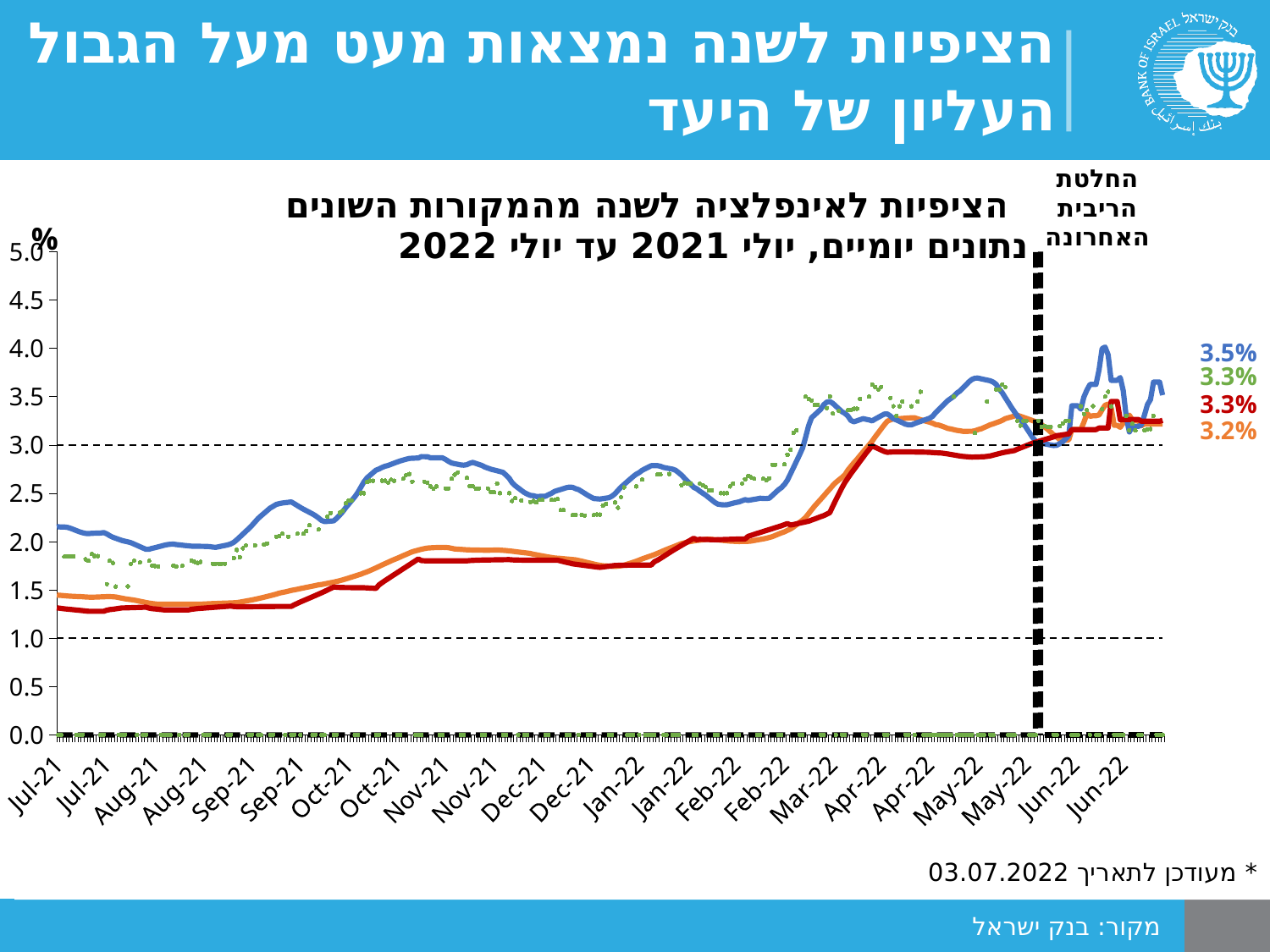
What unit is shown at the top of the vertical axis? % What is the final value labelled for the orange line at the right edge of the chart? 3.2% Overall, do the plotted lines rise or fall from Jul-21 to Jun-22? rise Which line has the lowest labelled end value? the orange line (3.2%) What is the difference between the labelled end values of the blue line (3.5%) and the orange line (3.2%)? 0.3 percentage points What is the final value labelled for the red line at the right edge of the chart? 3.3% What is the final value labelled for the blue line at the right edge of the chart? 3.5% What kind of chart is shown on the slide? line chart Which line has the highest labelled end value? the blue line (3.5%) How many lines are plotted on the chart? 4 Is the red line's value at the start of the chart (Jul-21) greater or less than 1.5? less Is the blue line's value at the start of the chart (Jul-21) greater or less than 2.0? greater